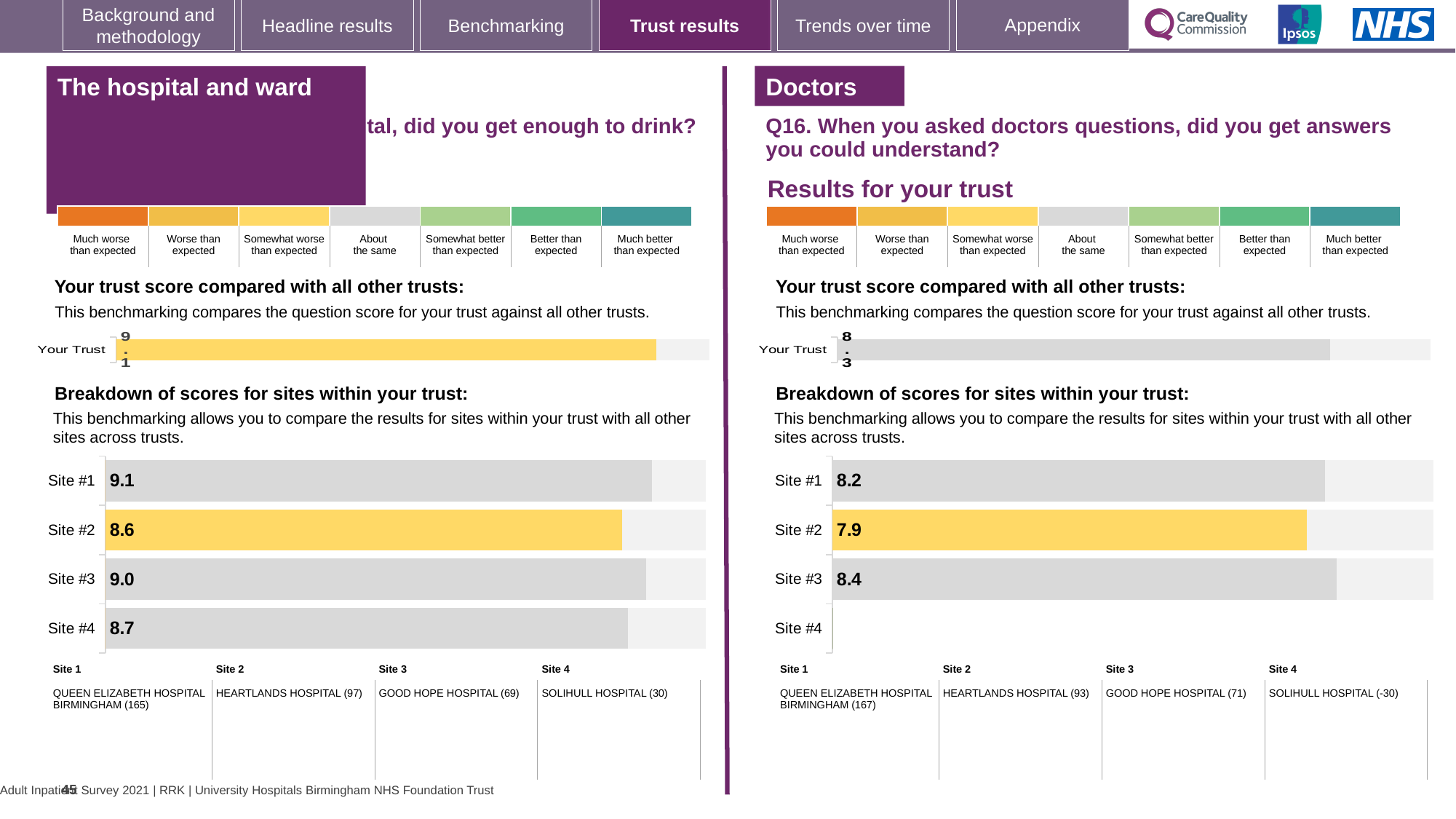
How many sites are listed in the site breakdown on the left-hand chart? 4 On the right-hand chart (Q16, doctors' answers), what is the score for Site #3? 8.4 On the left-hand chart (did you get enough to drink?), what is the score for Site #2? 8.6 On the left-hand chart, which site has the highest score? Site #1 On the left-hand chart, what is the difference between the scores for Site #1 and Site #4? 0.4 On the left-hand chart, what is the 'Your Trust' score? 9.1 What type of chart is used for the breakdown of scores for sites on the right-hand side? Bar chart On the right-hand chart, what is the difference between the scores for Site #3 and Site #2? 0.5 On the right-hand chart, which site has no bar plotted in the site breakdown? Site #4 On the right-hand chart (Q16), what is the 'Your Trust' score? 8.3 On the right-hand chart, which has the higher score, Site #1 or Site #3? Site #3 On the right-hand chart, which site has the lowest plotted score? Site #2